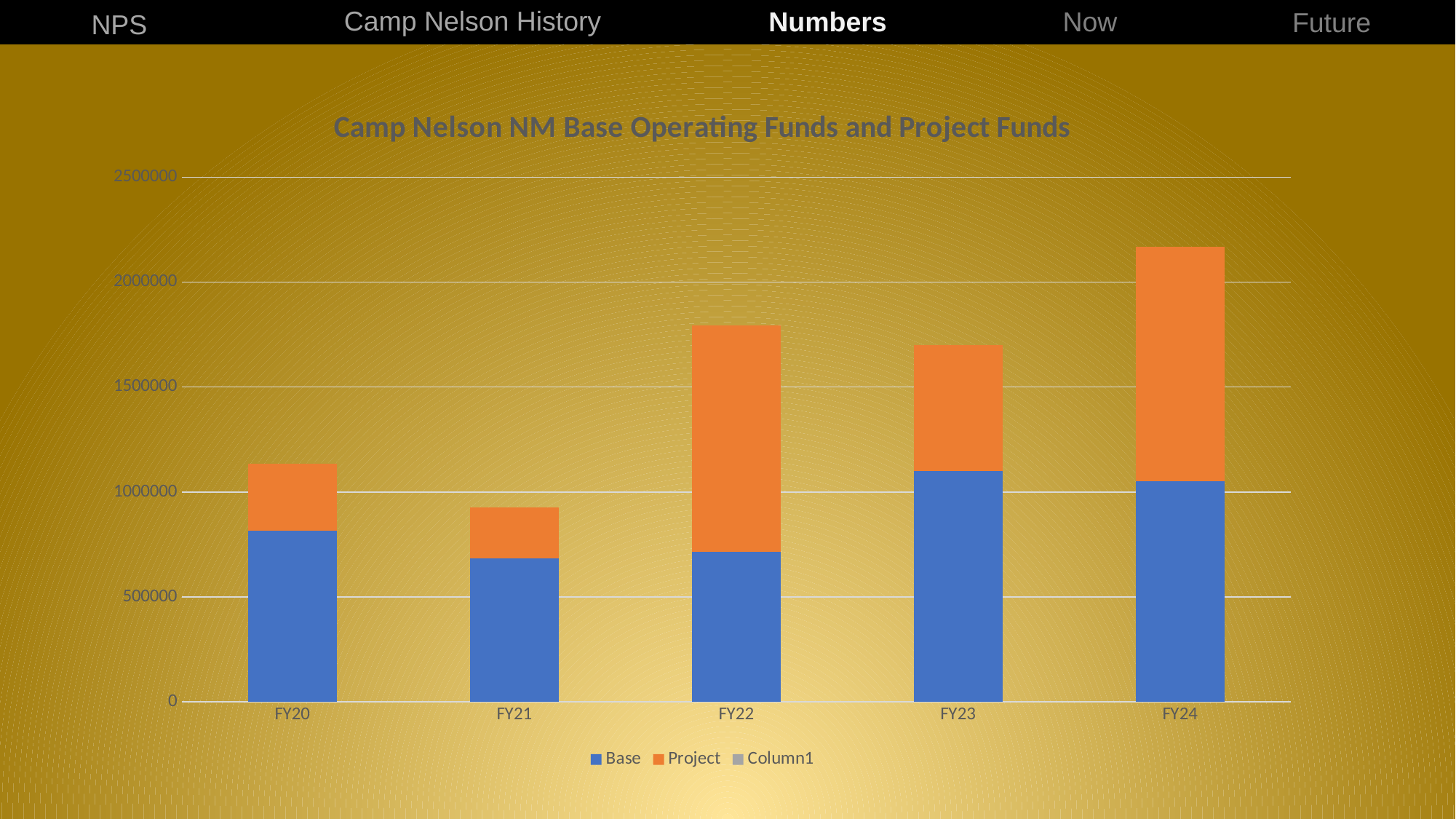
How many fiscal years are shown on the x axis of the chart? 5 What kind of chart is shown on the slide? Stacked bar chart How many series does the chart's legend list? 3 Which fiscal year has the highest total (Base plus Project) bar? FY24 Is the total bar for FY24 greater or less than 2000000? greater Which fiscal year has the lowest total (Base plus Project) bar? FY21 Which colour represents the Project series in the chart? Orange Which has the larger total bar, FY20 or FY21? FY20 Is the total bar for FY21 greater or less than 1000000? less Is the Base value for FY23 greater or less than 1000000? greater What is the title of the chart? Camp Nelson NM Base Operating Funds and Project Funds